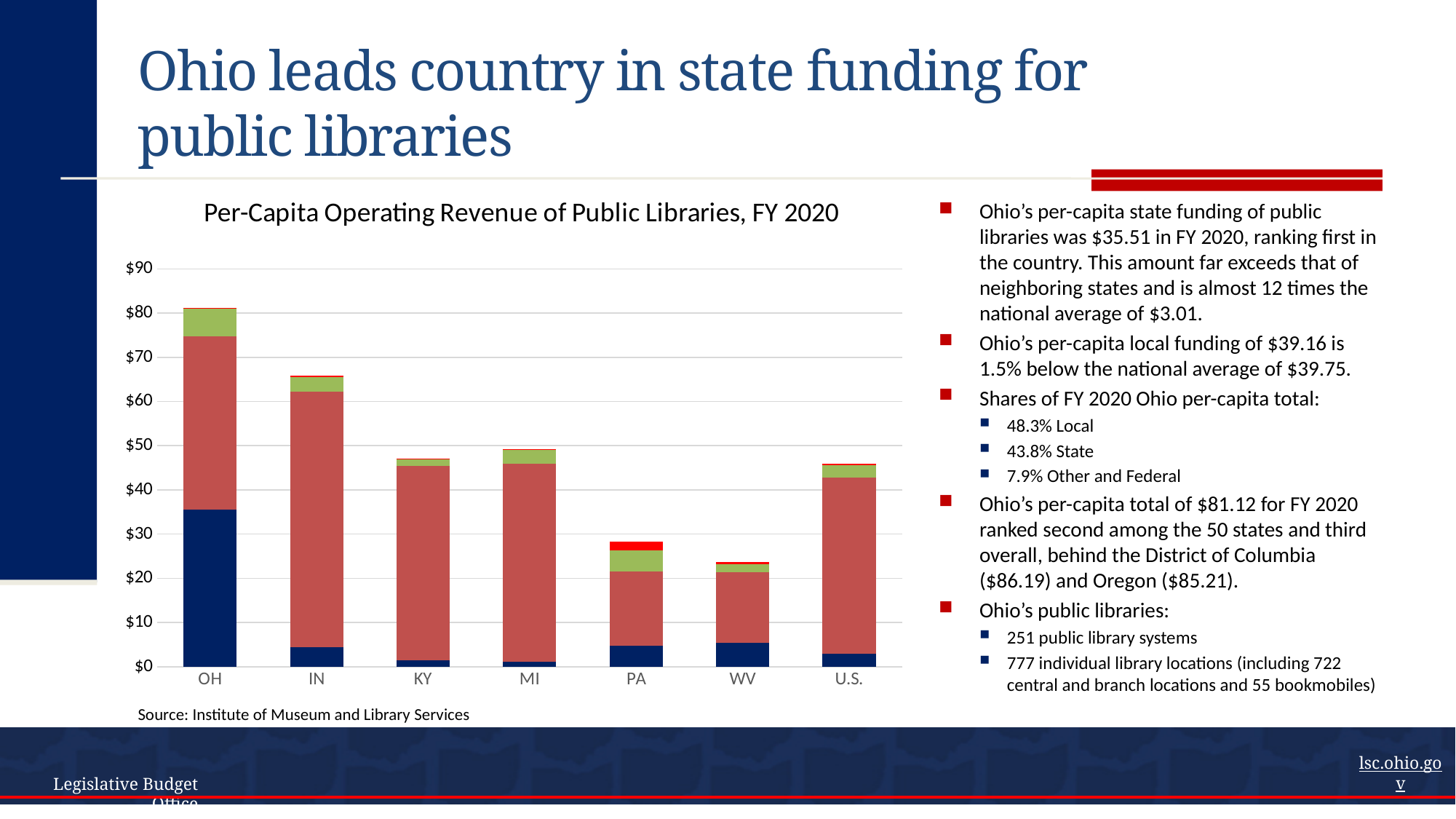
Is the total bar for PA greater or less than $30? less Is the total bar for U.S. greater or less than $50? less Is the total bar for IN greater or less than $60? greater Which category has the shortest bar in the chart? WV What is the title of the chart? Per-Capita Operating Revenue of Public Libraries, FY 2020 Which category has the tallest bar in the chart? OH Which has the taller bar, IN or U.S.? IN What kind of chart is shown on the slide? Stacked bar chart How many categories are shown on the x axis of the chart? 7 What source is cited below the chart? Institute of Museum and Library Services